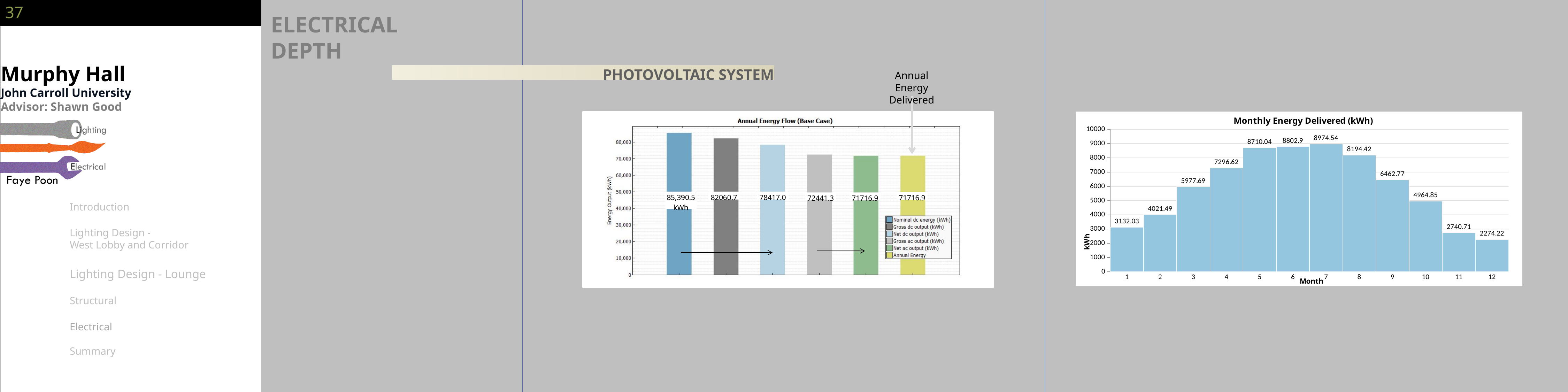
In the Monthly Energy Delivered (kWh) chart, how many months are plotted? 12 In the Monthly Energy Delivered (kWh) chart, do the values rise or fall from month 7 to month 12? fall In the Monthly Energy Delivered (kWh) chart, which is larger, month 4 or month 9? month 4 In the Monthly Energy Delivered (kWh) chart, what is the difference between month 7 and month 12? 6700.32 In the Monthly Energy Delivered (kWh) chart, which month has the highest value? 7 In the Monthly Energy Delivered (kWh) chart, what is the value for month 7? 8974.54 In the Monthly Energy Delivered (kWh) chart, which month has the lowest value? 12 What kind of chart is the Monthly Energy Delivered (kWh) chart? bar chart In the Annual Energy Flow (Base Case) chart, what is the difference between the Nominal dc energy bar and the Annual Energy bar? 13,673.6 In the Annual Energy Flow (Base Case) chart, how many series does the legend list? 6 In the Monthly Energy Delivered (kWh) chart, what is the value for month 1? 3132.03 In the Annual Energy Flow (Base Case) chart, what is the value of the Gross dc output bar? 82060.7